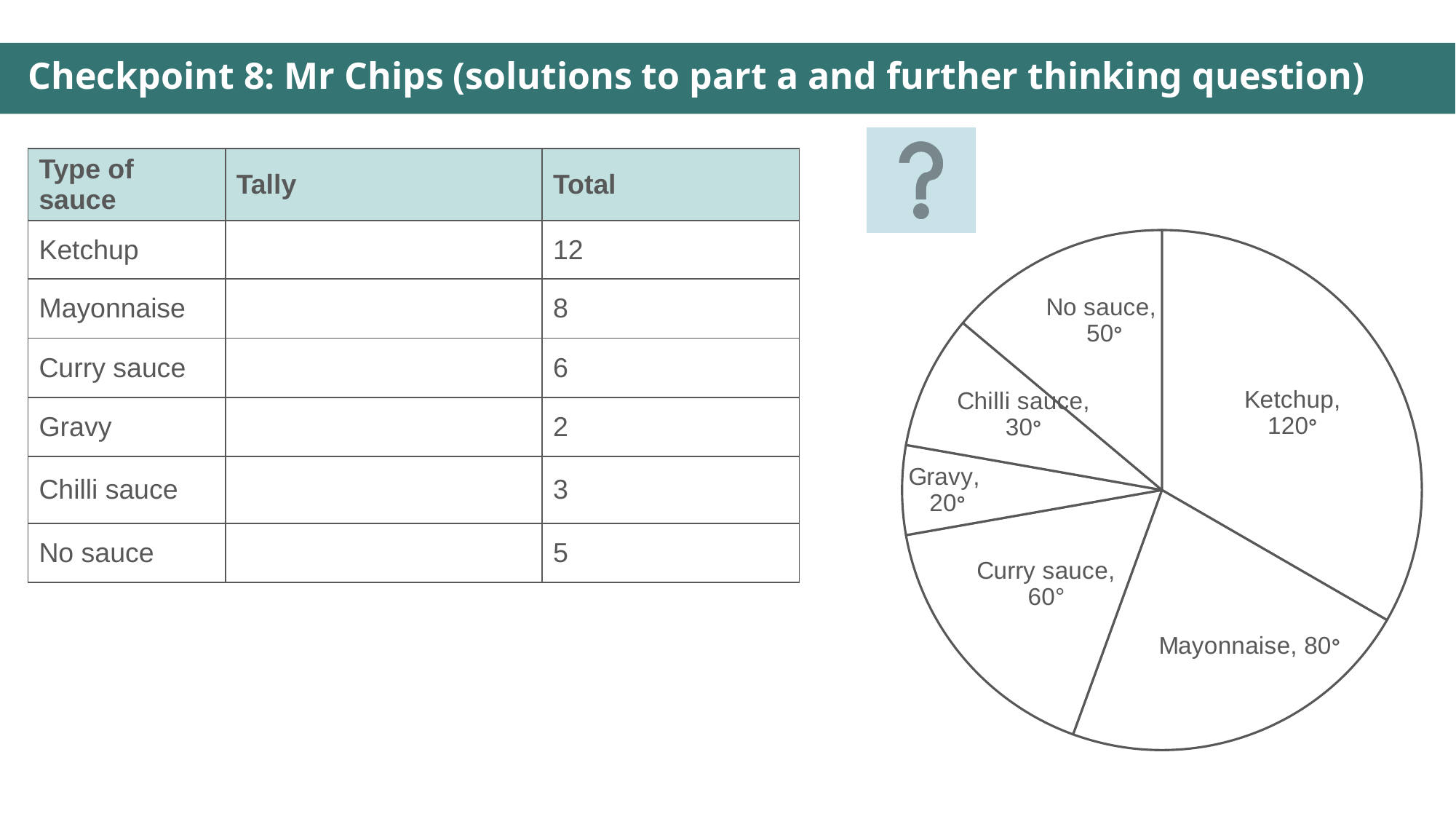
In the pie chart, what angle is shown for the No sauce slice? 50° What type of chart is shown on the slide? pie chart In the pie chart, which slice is larger: Chilli sauce or No sauce? No sauce In the pie chart, what is the difference in degrees between the Ketchup slice and the Curry sauce slice? 60° In the pie chart, what angle is shown for the Ketchup slice? 120° Which slice of the pie chart is the largest? Ketchup What fraction of the whole pie chart does the Ketchup slice represent? one third In the pie chart, what angle is shown for the Gravy slice? 20° In the pie chart, what angle is shown for the Mayonnaise slice? 80° Which slice of the pie chart is the smallest? Gravy How many slices does the pie chart have? 6 In the pie chart, what is the combined angle of the Gravy and Chilli sauce slices? 50°